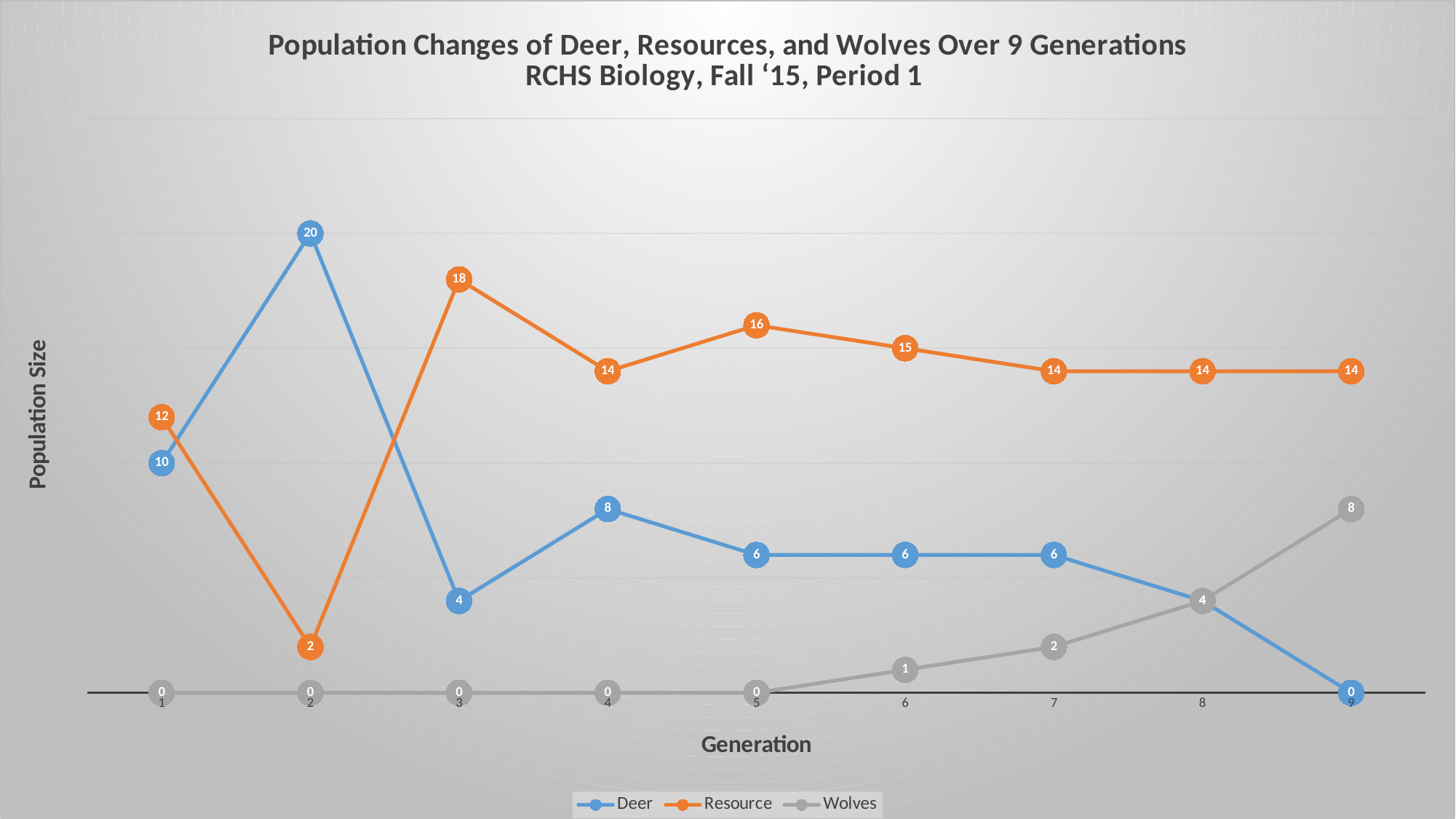
What is the difference between the Resource value and the Deer population in generation 1? 2 Does the Wolves population rise or fall from generation 5 to generation 9? Rise In which generation is the Resource value lowest? 2 What is the Deer population in generation 2? 20 What is the label of the y axis? Population Size In which generation is the Deer population highest? 2 What is the Resource value in generation 3? 18 In generation 4, which is larger, the Deer population or the Resource value? Resource How many series does the legend list? 3 What kind of chart is shown on the slide? Line chart How many generations are plotted on the x axis? 9 What is the Wolves population in generation 9? 8